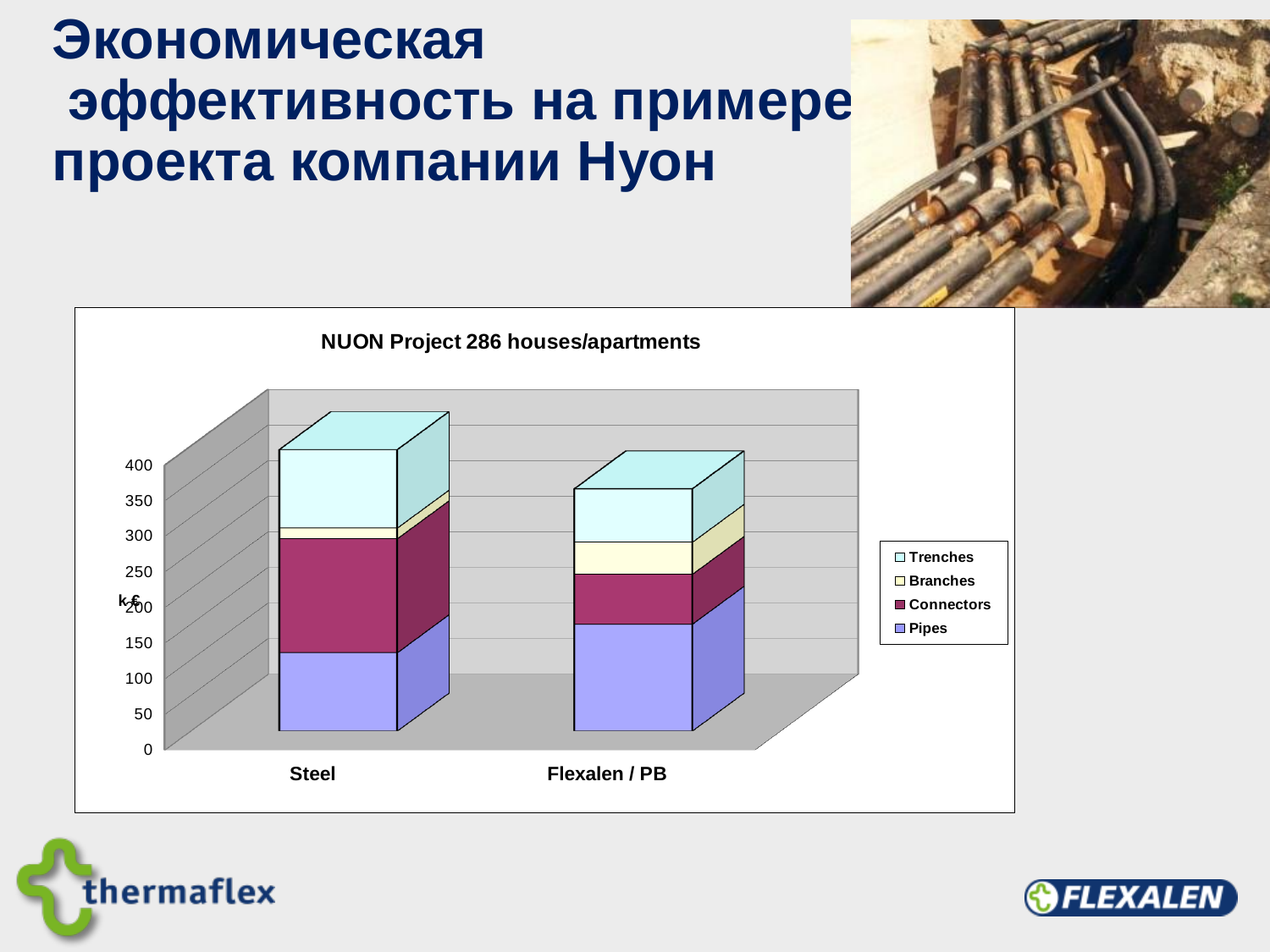
Which category has the taller stacked bar, Steel or Flexalen / PB? Steel Is the Pipes value for Steel greater or less than 150? less How many categories are shown on the x axis of the chart? 2 What unit label is shown on the vertical axis of the chart? k € What kind of chart is shown on the slide? Stacked bar chart How many series does the chart legend list? 4 Which category has the larger Branches segment, Steel or Flexalen / PB? Flexalen / PB Is the total value for Flexalen / PB greater or less than 300? greater What is the title of the chart? NUON Project 286 houses/apartments Which category has the lower total bar? Flexalen / PB Which category has the larger Connectors segment, Steel or Flexalen / PB? Steel Is the total value for Steel greater or less than 350? greater